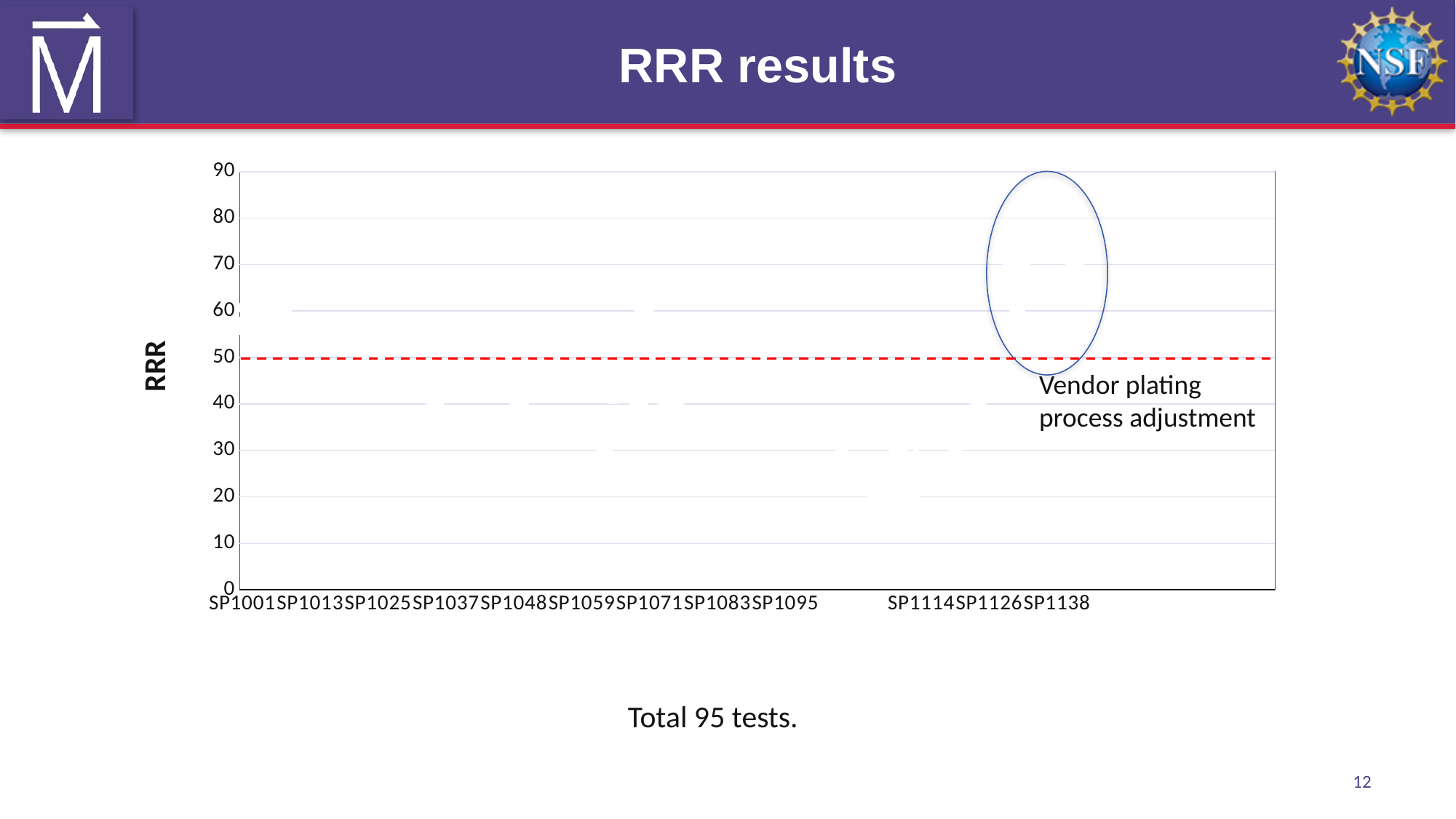
What is the last sample label shown on the horizontal axis? SP1138 What is the first sample label shown on the horizontal axis? SP1001 According to the text below the chart, how many tests were performed in total? 95 What is the label on the vertical axis of the chart? RRR How many sample labels are printed along the horizontal axis? 12 What does the annotation next to the blue ellipse say? Vendor plating process adjustment At what RRR value is the red dashed horizontal line drawn? 50 What is the title of the chart? RRR results What is the highest value shown on the vertical axis? 90